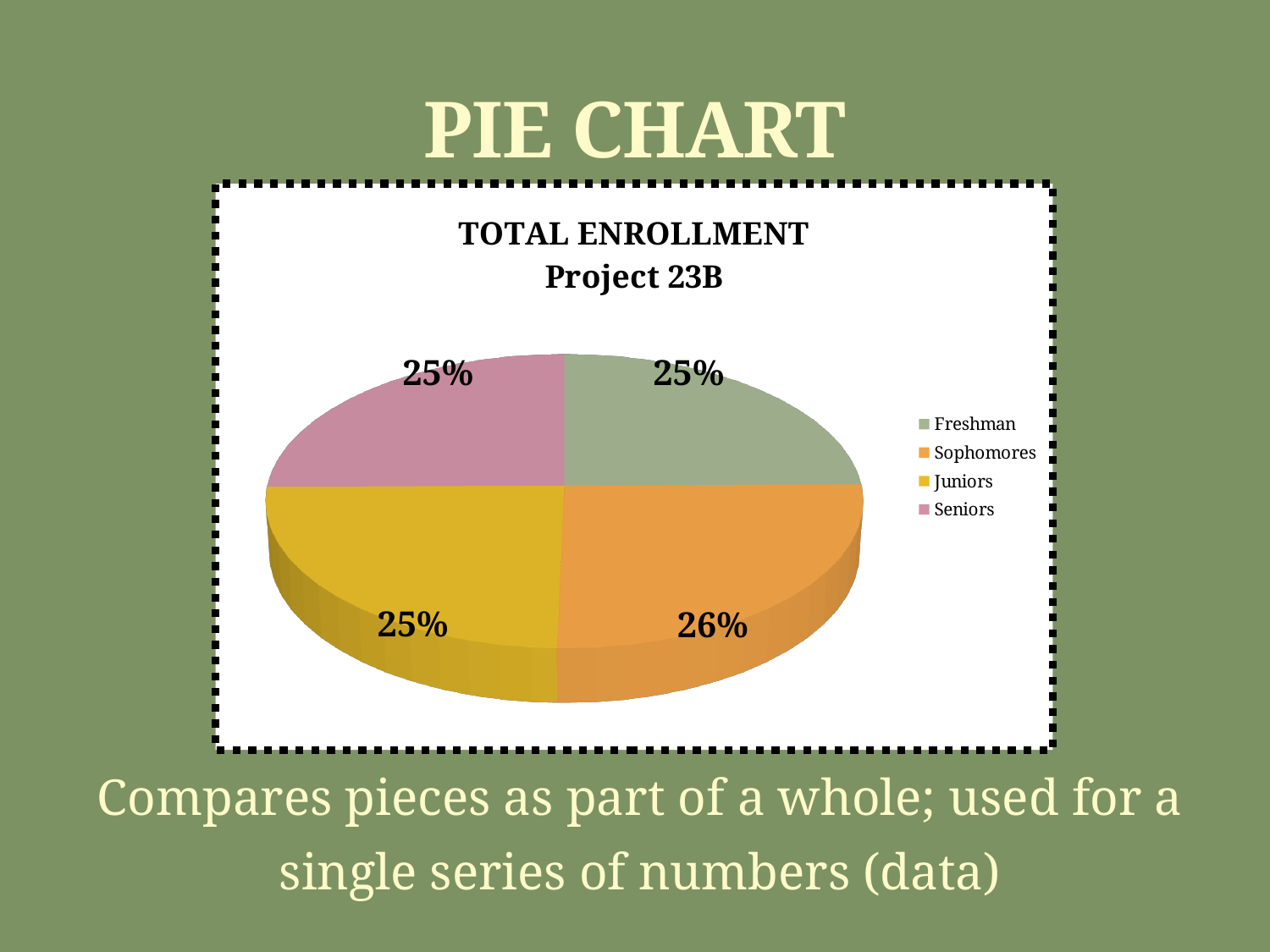
What percentage of the pie does the Seniors slice represent? 25% What percentage of the pie does the Sophomores slice represent? 26% What colour is the Seniors slice in the pie chart? Pink Which category has the largest slice of the pie? Sophomores How many slices does the pie chart have? 4 What kind of chart is shown on the slide? Pie chart How many entries does the legend list? 4 What percentage of the pie does the Freshman slice represent? 25% What is the difference in percentage points between the Sophomores slice and the Freshman slice? 1% What is the title of the chart? TOTAL ENROLLMENT Project 23B Which slice is larger, Sophomores or Juniors? Sophomores What percentage of the pie does the Juniors slice represent? 25%